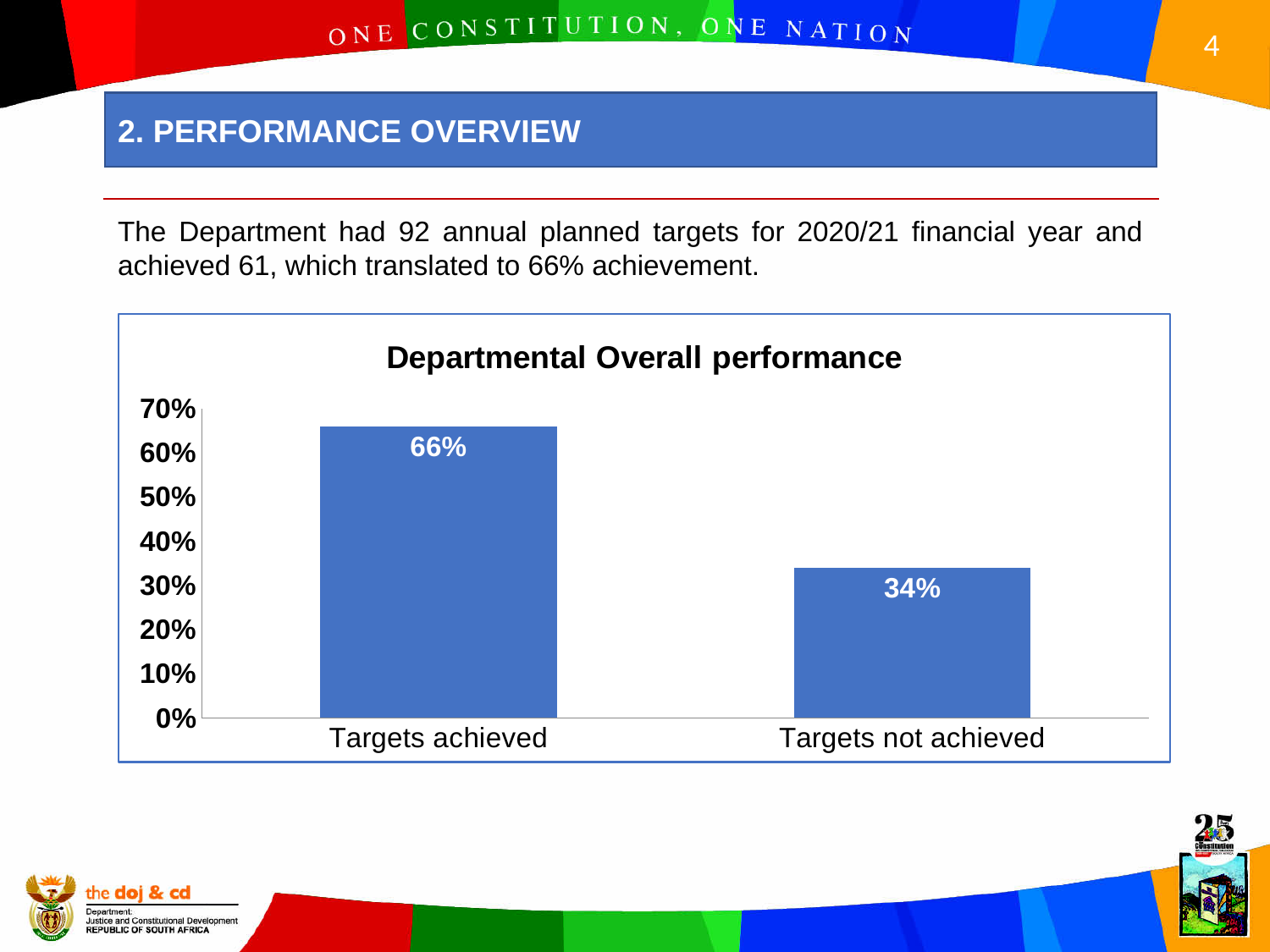
What is the highest value shown on the y axis? 70% What is the value for Targets achieved? 66% What is the title of the chart? Departmental Overall performance Is the value for Targets achieved greater or less than 60%? greater How many categories are shown on the x axis? 2 Is the value for Targets not achieved greater or less than 40%? less Which category has the lowest value? Targets not achieved Which category has the highest value? Targets achieved What kind of chart is shown on the slide? bar chart Which is larger, the value for Targets achieved or the value for Targets not achieved? Targets achieved What is the difference between the values for Targets achieved and Targets not achieved? 32% What is the value for Targets not achieved? 34%